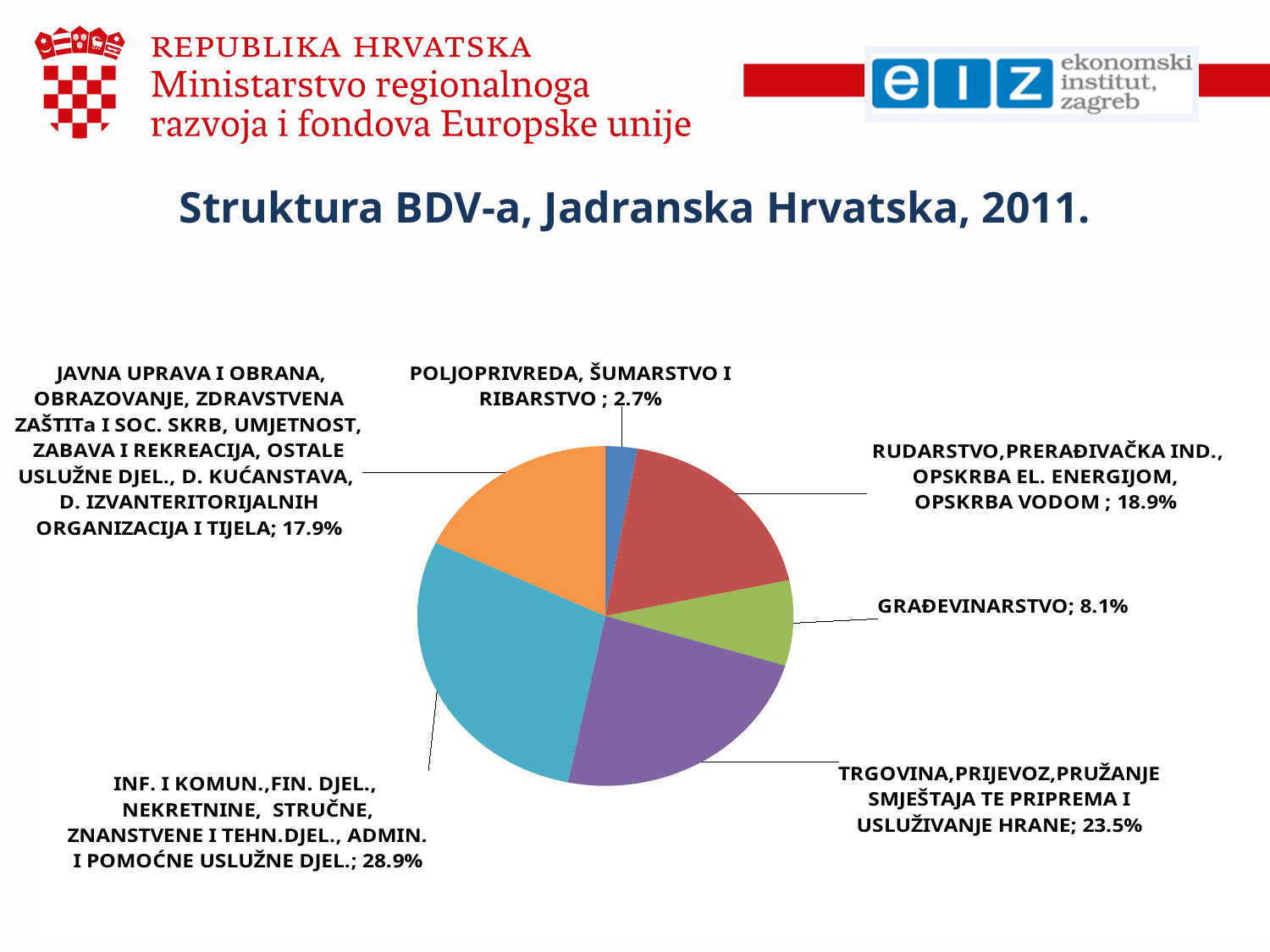
How many slices does the pie chart have? 6 What is the value shown for RUDARSTVO, PRERAĐIVAČKA IND., OPSKRBA EL. ENERGIJOM, OPSKRBA VODOM? 18.9% What colour is the slice for GRAĐEVINARSTVO? green What is the combined share of the two largest slices, INF. I KOMUN.... (28.9%) and TRGOVINA, PRIJEVOZ... (23.5%)? 52.4% What is the title of the chart? Struktura BDV-a, Jadranska Hrvatska, 2011. Which category has the smallest share of the pie? POLJOPRIVREDA, ŠUMARSTVO I RIBARSTVO What is the difference between the share of TRGOVINA, PRIJEVOZ, PRUŽANJE SMJEŠTAJA TE PRIPREMA I USLUŽIVANJE HRANE and the share of GRAĐEVINARSTVO? 15.4% What kind of chart is shown on the slide? pie chart Which is larger: the share of RUDARSTVO, PRERAĐIVAČKA IND., OPSKRBA EL. ENERGIJOM, OPSKRBA VODOM or the share of JAVNA UPRAVA I OBRANA, OBRAZOVANJE, ZDRAVSTVENA ZAŠTITA I SOC. SKRB...? RUDARSTVO, PRERAĐIVAČKA IND., OPSKRBA EL. ENERGIJOM, OPSKRBA VODOM Which category has the largest share of the pie? INF. I KOMUN., FIN. DJEL., NEKRETNINE, STRUČNE, ZNANSTVENE I TEHN. DJEL., ADMIN. I POMOĆNE USLUŽNE DJEL. What is the value shown for POLJOPRIVREDA, ŠUMARSTVO I RIBARSTVO? 2.7% What share of the pie is GRAĐEVINARSTVO? 8.1%